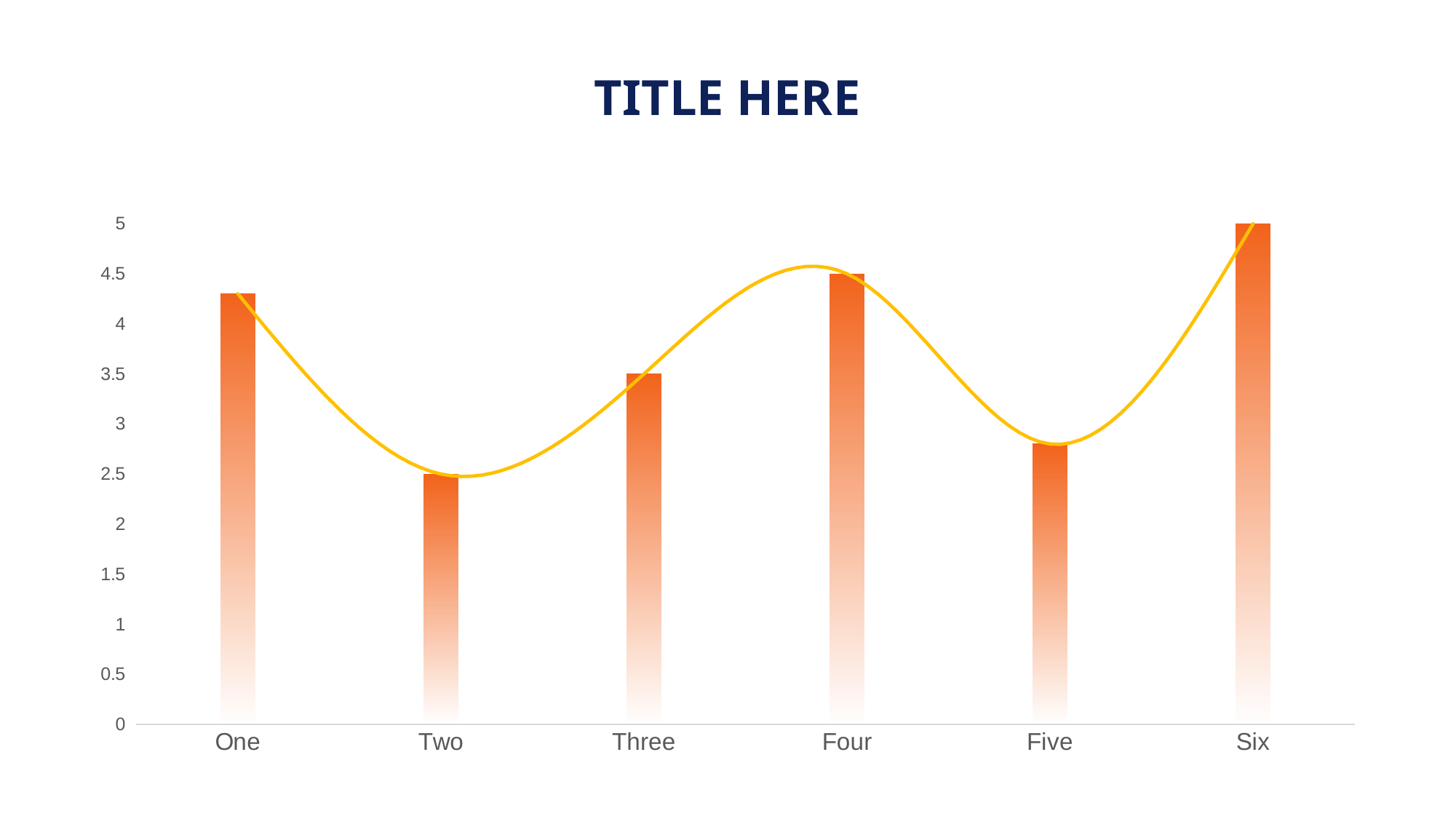
What is the title of the chart? TITLE HERE What is the value for Four? 4.5 What is the value for Two? 2.5 Which is larger, the value for Three or the value for Five? Three What is the value for Six? 5 How many categories are shown on the x axis? 6 Is the value for Five greater or less than 3? less Which category has the highest value? Six What type of chart is shown on the slide? bar and line chart Is the value for One greater or less than 4? greater What is the difference between the values for Six and Four? 0.5 Which category has the lowest value? Two